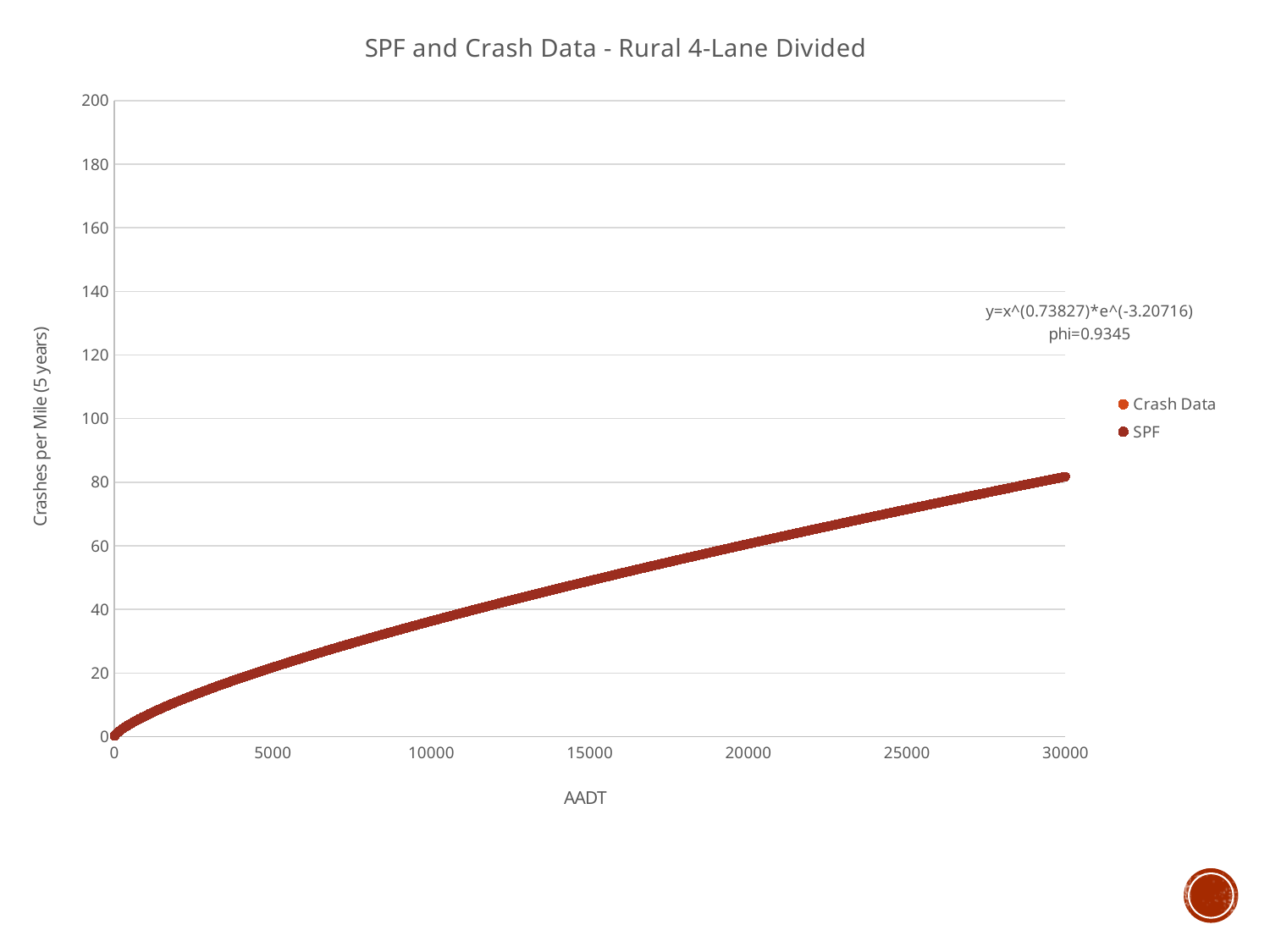
Is the SPF value at an AADT of 30000 greater or less than 100? less Is the SPF value at an AADT of 20000 greater or less than 40? greater Is the SPF value at an AADT of 30000 greater or less than 60? greater What are the names of the series listed in the legend? Crash Data and SPF What is the title of the chart? SPF and Crash Data - Rural 4-Lane Divided What is the label of the x axis? AADT How many series does the legend list? 2 What kind of chart is shown on the slide? Scatter chart Do the SPF values rise or fall as AADT increases along the x axis? Rise